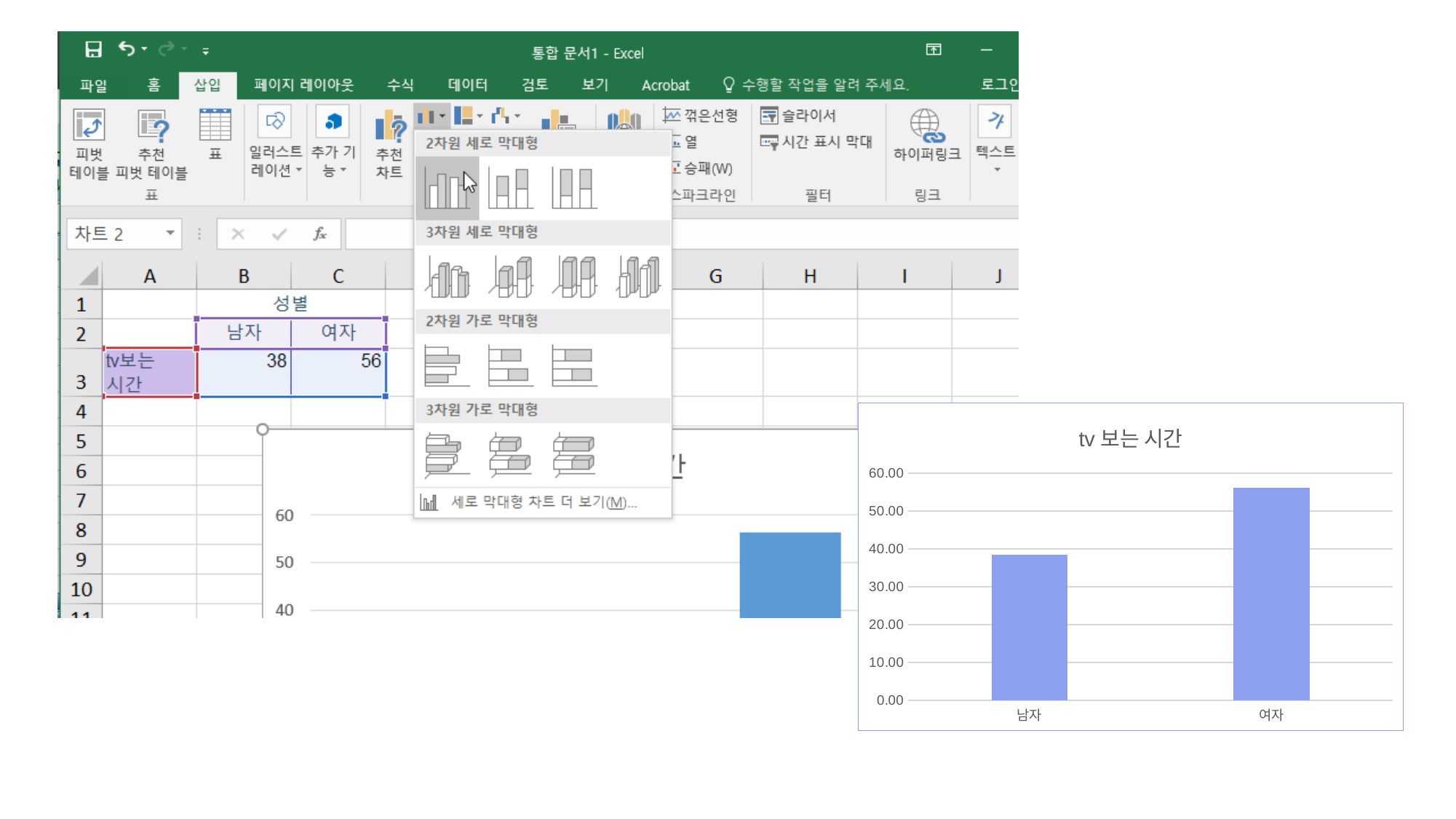
What kind of chart is the chart on the right titled 'tv 보는 시간'? bar chart What is the title of the chart on the right side of the slide? tv 보는 시간 In the chart on the right titled 'tv 보는 시간', which category has the lowest bar? 남자 In the chart on the right titled 'tv 보는 시간', how many categories are shown on the x axis? 2 In the chart on the right titled 'tv 보는 시간', is the value for 여자 greater or less than 50.00? greater Using the values in the spreadsheet table, what is the difference between the 여자 and 남자 values plotted in the chart 'tv 보는 시간'? 18 According to the spreadsheet table on the slide, what is the value for 남자 plotted in the chart 'tv 보는 시간'? 38 In the chart on the right titled 'tv 보는 시간', what is the highest tick label shown on the y axis? 60.00 In the chart on the right titled 'tv 보는 시간', which is larger, the value for 남자 or the value for 여자? 여자 In the chart on the right titled 'tv 보는 시간', is the value for 남자 greater or less than 40.00? less According to the spreadsheet table on the slide, what is the value for 여자 plotted in the chart 'tv 보는 시간'? 56 In the chart on the right titled 'tv 보는 시간', which category has the highest bar? 여자